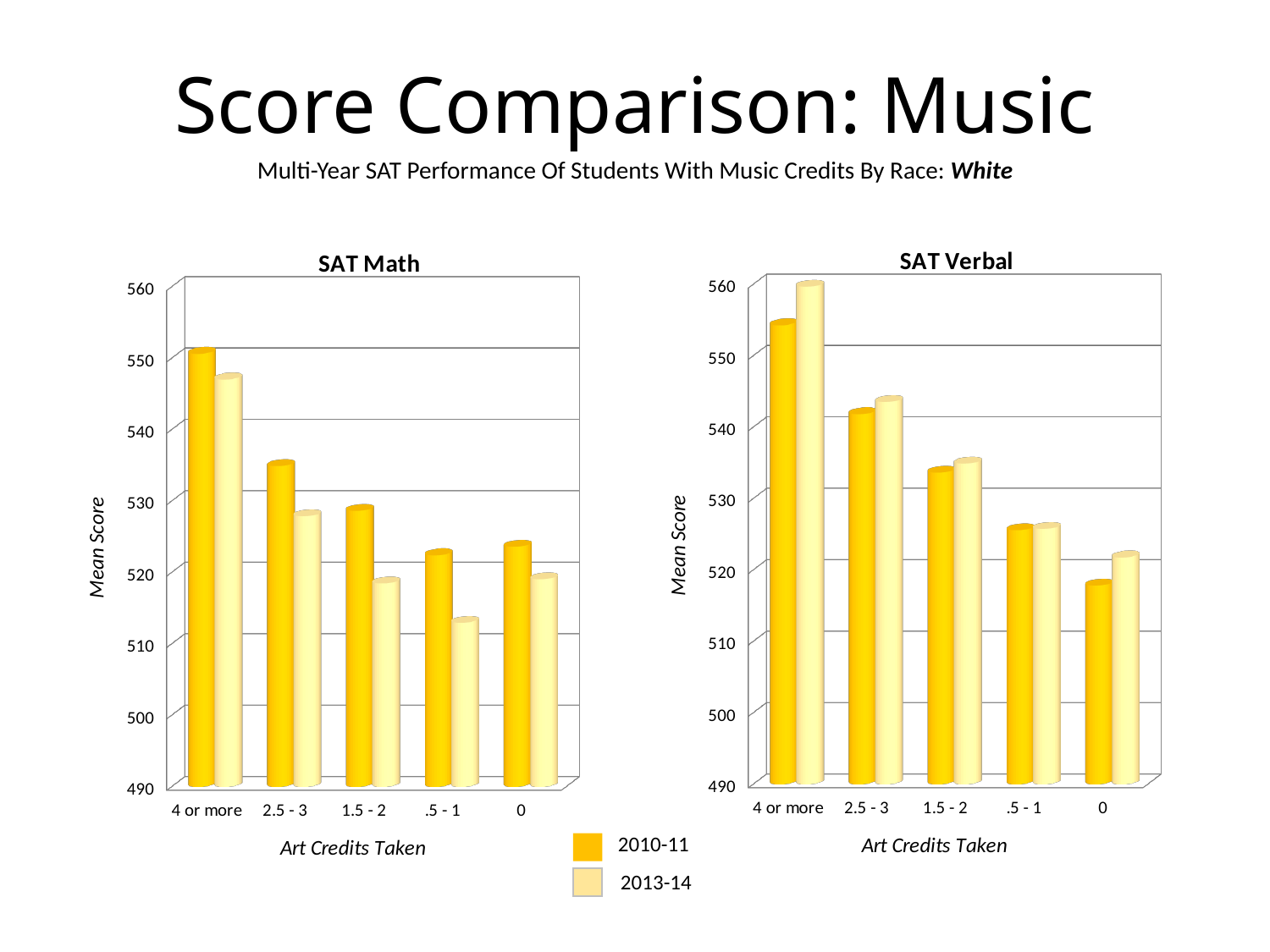
In the SAT Verbal chart, which art-credit category has the lowest 2010-11 score? 0 In the SAT Verbal chart, do the 2010-11 values rise or fall from left to right along the x axis? fall In the SAT Math chart, which art-credit category has the lowest 2013-14 score? .5 - 1 How many series does the legend list? 2 In the SAT Math chart, is the 2013-14 value for ".5 - 1" greater or less than 520? less In the SAT Math chart, is the 2010-11 value for "4 or more" greater or less than 540? greater In the SAT Math chart, for "2.5 - 3" credits, which series has the larger value, 2010-11 or 2013-14? 2010-11 How many categories are shown on the x axis of the SAT Verbal chart? 5 In the SAT Math chart, which art-credit category has the highest 2010-11 score? 4 or more In the SAT Verbal chart, for "4 or more" credits, which series has the larger value, 2010-11 or 2013-14? 2013-14 What kind of chart is the SAT Math chart? bar chart In the SAT Verbal chart, is the 2013-14 value for "4 or more" greater or less than 550? greater